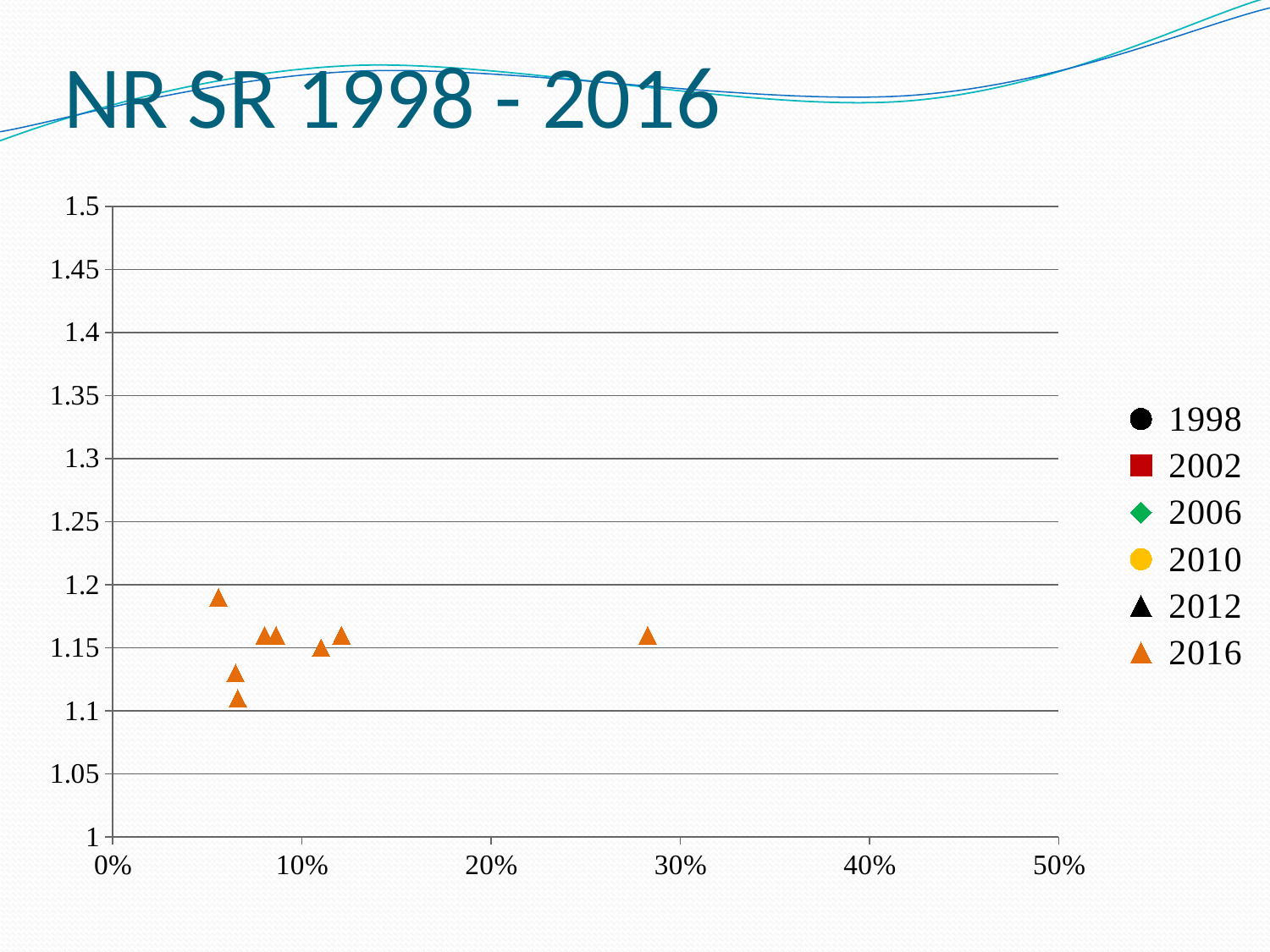
Is the x value of the rightmost 2016 point greater or less than 20%? greater What is the maximum value shown on the x axis? 50% How many series does the legend list? 6 How many 2016 points are plotted on the chart? 8 What kind of chart is shown on the slide? scatter chart Is the y value of the highest 2016 point greater or less than 1.3? less Which series is the only one with points visible on the chart? 2016 Is the y value of the lowest 2016 point greater or less than 1.05? greater Is the leftmost 2016 point higher or lower on the y axis than the rightmost 2016 point? higher Which series is plotted with orange triangles? 2016 What is the title of the chart? NR SR 1998 - 2016